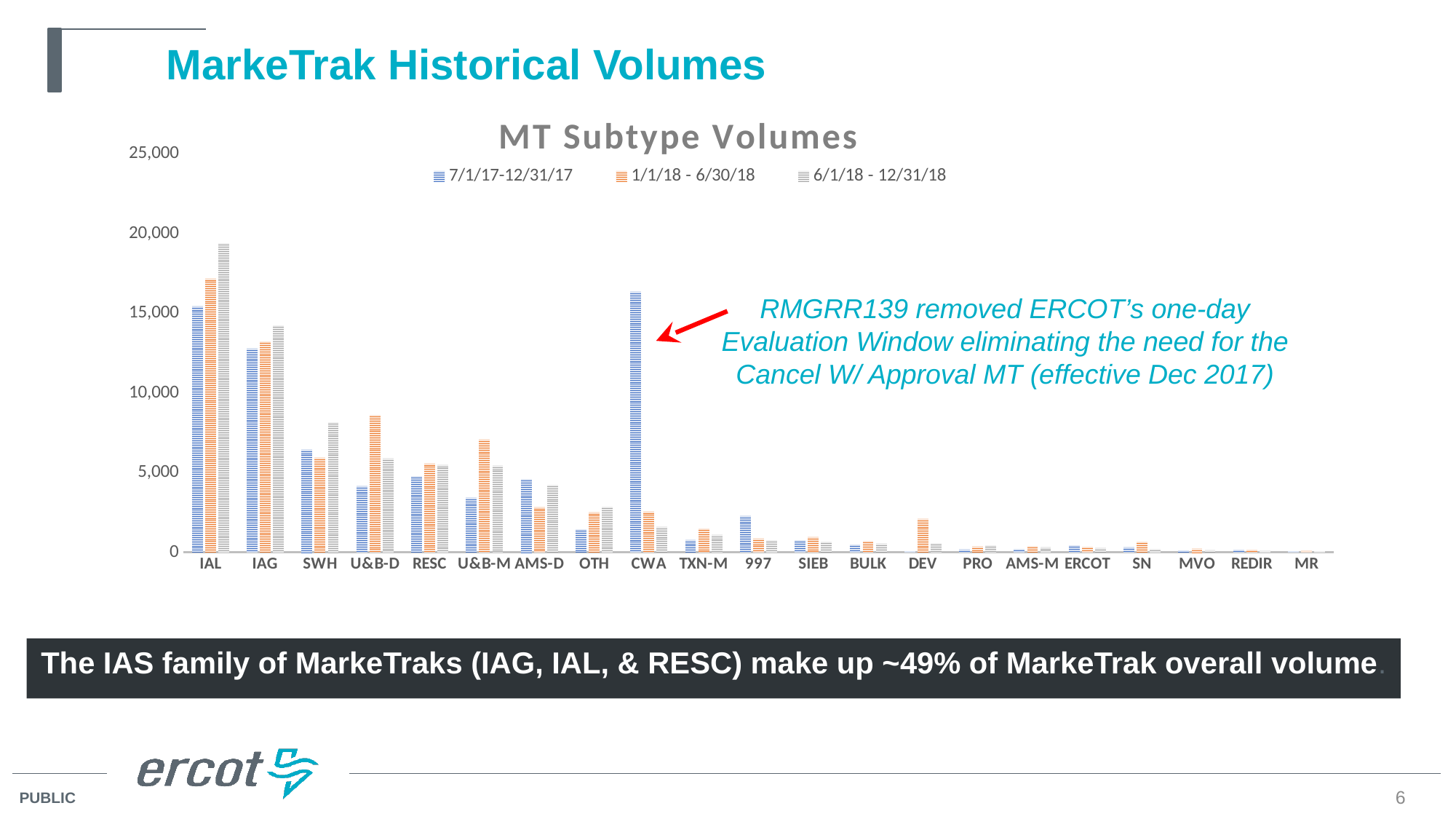
What is the title of the chart? MT Subtype Volumes Which category has the highest value for the 7/1/17-12/31/17 series? CWA For U&B-D, which series has the larger value: 1/1/18 - 6/30/18 or 6/1/18 - 12/31/18? 1/1/18 - 6/30/18 Is the value for SWH in the 6/1/18 - 12/31/18 series greater or less than 5,000? greater For CWA, which series has the larger value: 7/1/17-12/31/17 or 1/1/18 - 6/30/18? 7/1/17-12/31/17 Which category has the highest value for the 6/1/18 - 12/31/18 series? IAL Is the value for IAG in the 1/1/18 - 6/30/18 series greater or less than 10,000? greater Is the value for CWA in the 1/1/18 - 6/30/18 series greater or less than 5,000? less How many series does the chart's legend list? 3 What kind of chart is shown on the slide? bar chart How many MT subtype categories are shown along the x axis? 21